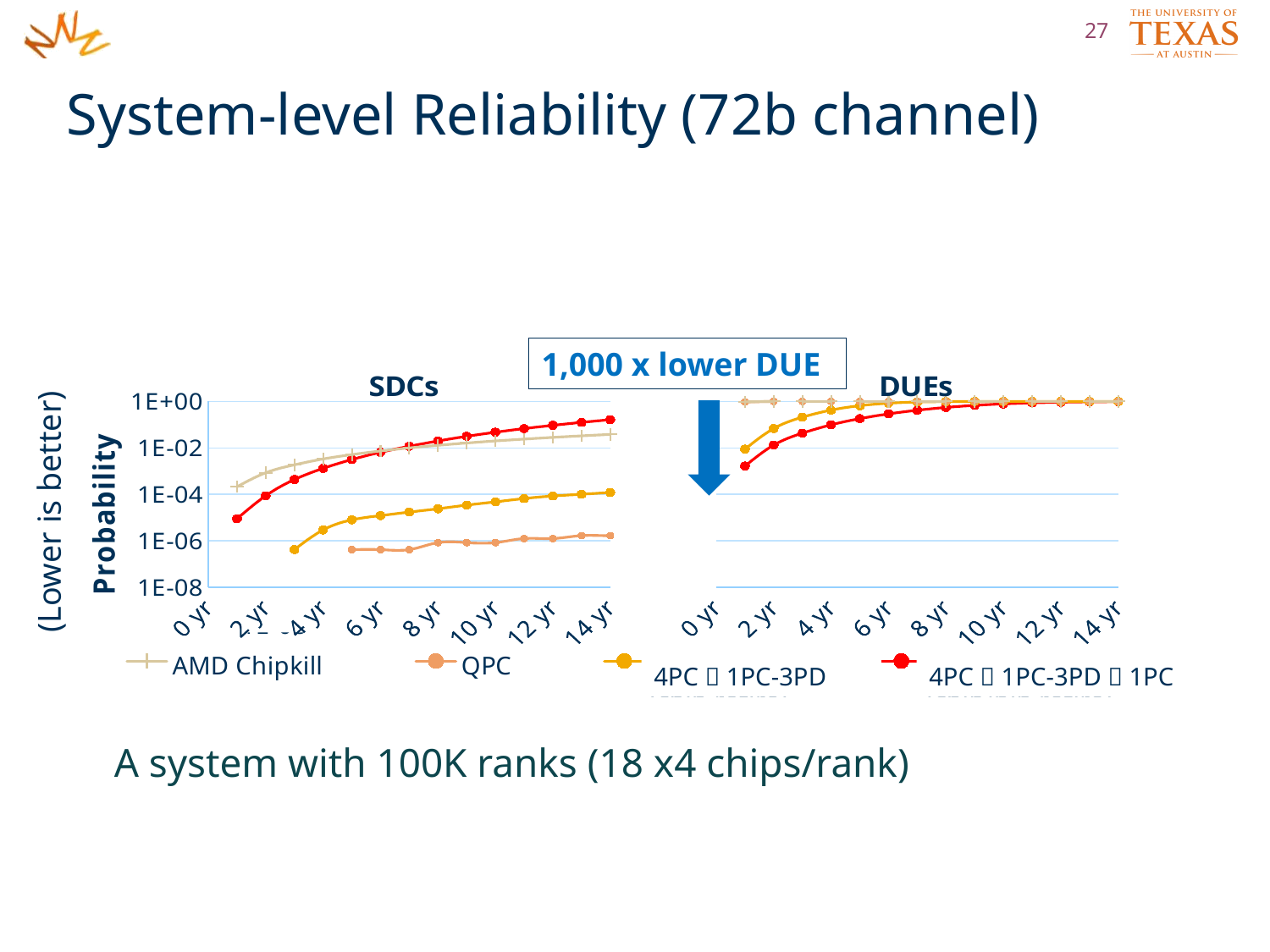
In the SDCs chart, which series has the highest probability at 14 yr? 4PC → 1PC-3PD → 1PC In the SDCs chart, is the value for QPC at 14 yr greater or less than 1E-04? less In the SDCs chart, is the value for 4PC → 1PC-3PD → 1PC at 14 yr greater or less than 1E-02? greater How many year labels are shown on the x axis of the DUEs chart? 8 In the SDCs chart, which is larger at 14 yr: AMD Chipkill or QPC? AMD Chipkill What kind of chart is the SDCs chart? line chart What does the annotation box above the DUEs chart say? 1,000 x lower DUE How many series does the legend list? 4 In the DUEs chart, is the value for AMD Chipkill at 14 yr greater or less than 1E-02? greater In the SDCs chart, which series has the lowest probability at 14 yr? QPC In the SDCs chart, do the probabilities rise or fall as the years increase? rise